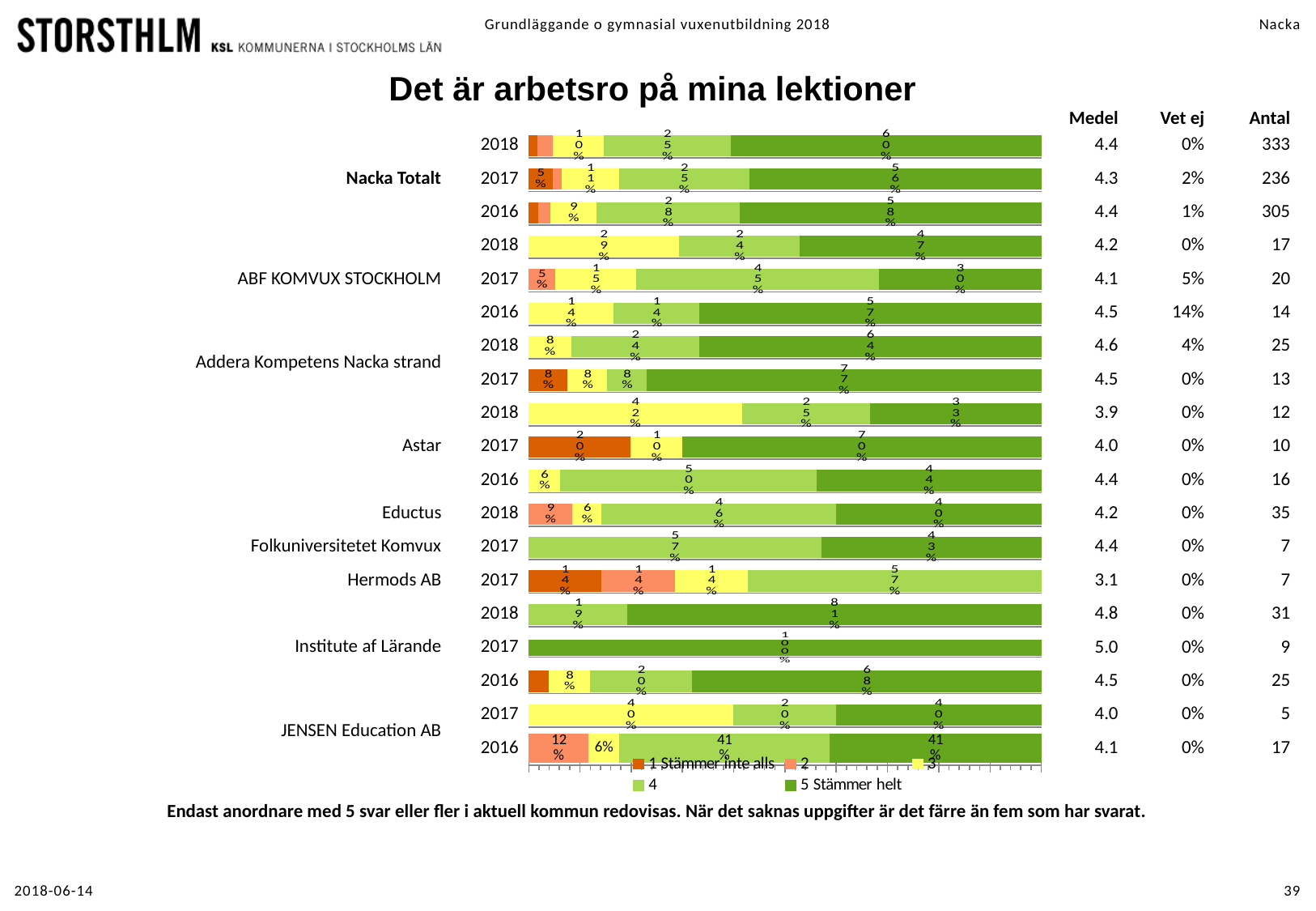
What kind of chart is shown on the slide? bar chart What share of JENSEN Education AB 2016 responses is '2'? 12% What share of Institute af Lärande 2017 responses is '5 Stämmer helt'? 100% What is the difference in percentage points between the '5 Stämmer helt' share for Nacka Totalt 2018 and Nacka Totalt 2017? 4 Which bar has the highest share of '5 Stämmer helt'? Institute af Lärande 2017 What is the title of the chart? Det är arbetsro på mina lektioner How many bars are plotted in the chart? 19 How many series does the legend list? 5 What share of Hermods AB 2017 responses is '4'? 57% Which is larger: the '5 Stämmer helt' share for Astar 2017 or for Astar 2018? Astar 2017 What share of Nacka Totalt 2018 responses is '5 Stämmer helt'? 60% What share of Astar 2018 responses is '3'? 42%